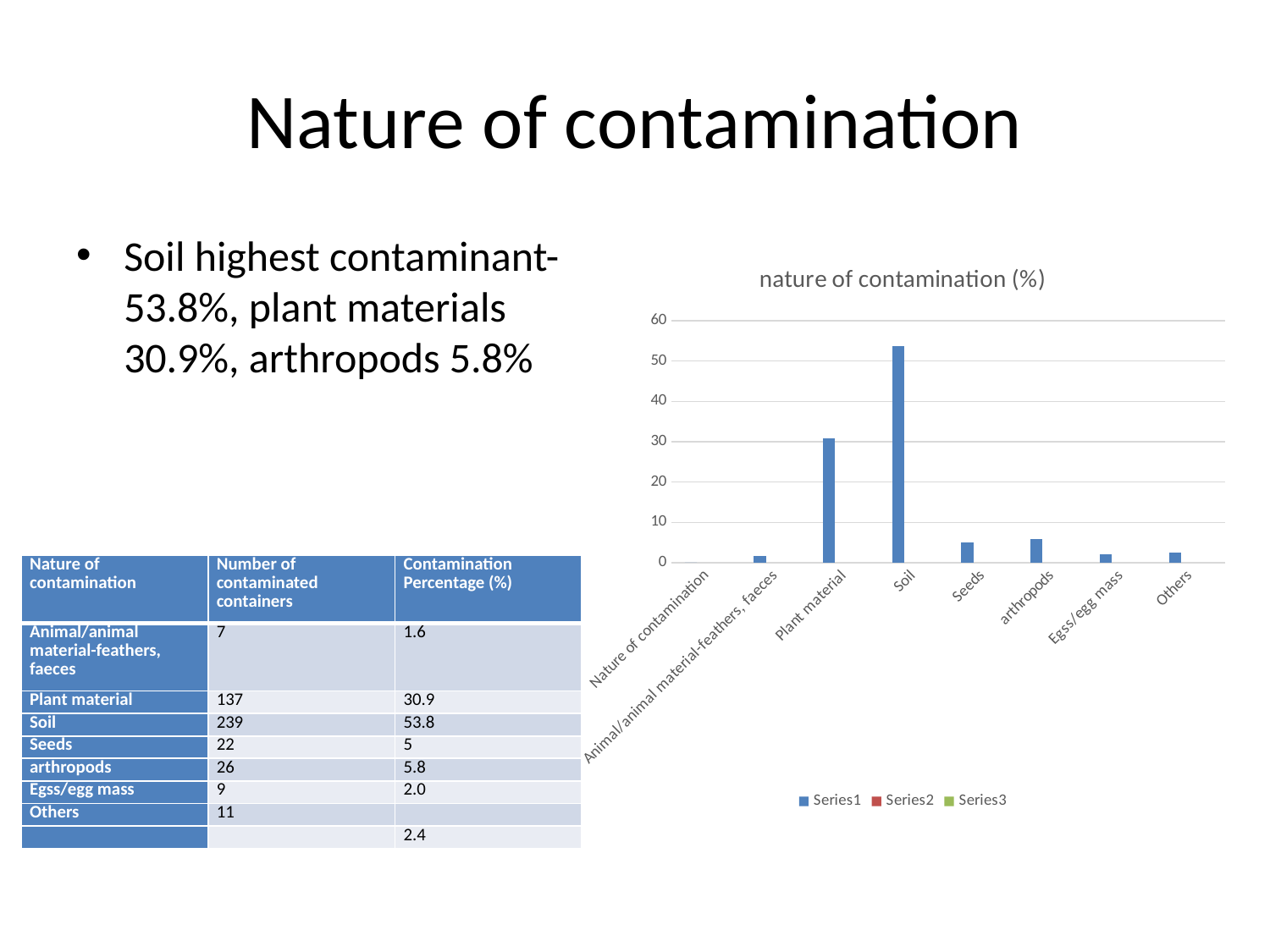
Which category has the highest bar in the chart? Soil Is the value for Soil in the chart greater or less than 50? greater Is the value for arthropods in the chart greater or less than 10? less Which is larger in the chart, the value for Plant material or the value for Soil? Soil What kind of chart is shown on the slide? bar chart Is the value for Plant material in the chart greater or less than 40? less What is the title of the chart? nature of contamination (%) How many series does the chart's legend list? 3 What is the contamination percentage for Soil plotted in the chart? 53.8 What is the difference between the contamination percentage for Soil and for Plant material? 22.9 Which is larger in the chart, the value for Plant material or the value for Seeds? Plant material